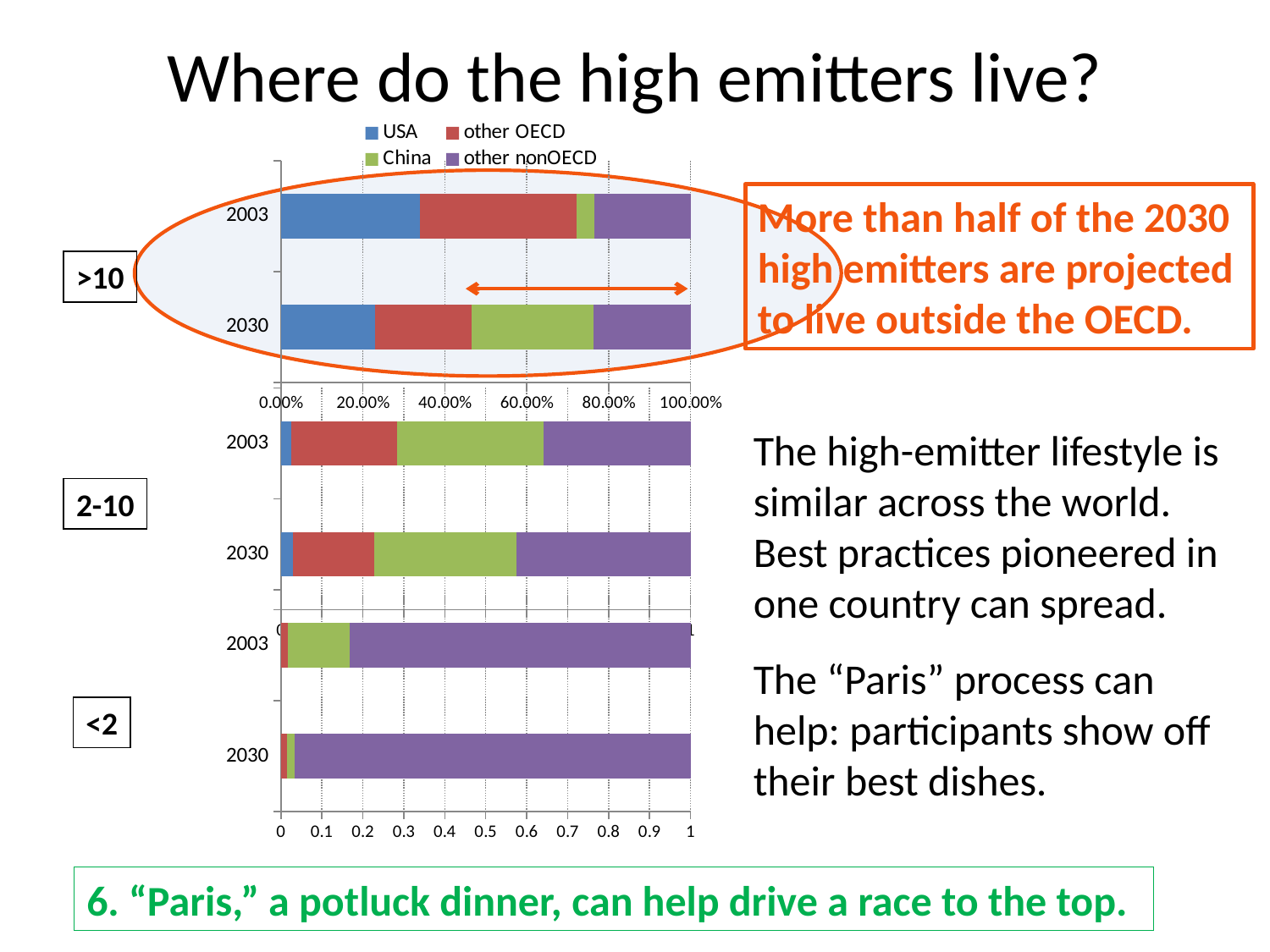
In the ">10" chart, is the China share for 2003 greater or less than 20.00%? less How many series does the legend list for the charts? 4 In the ">10" chart, is the USA share for 2003 greater or less than 20.00%? greater In the ">10" chart, is the China share larger in 2003 or in 2030? 2030 Which two years are compared in each of the three charts? 2003 and 2030 In the "2-10" chart, is the China share for 2003 greater or less than 20.00%? greater How many categories (years) are shown in the "2-10" chart? 2 In the "<2" chart, is the China share larger in 2003 or in 2030? 2003 Which series are listed in the legend? USA, other OECD, China, other nonOECD What kind of chart is the ">10" chart on the slide? stacked bar chart In the ">10" chart, is the USA share larger in 2003 or in 2030? 2003